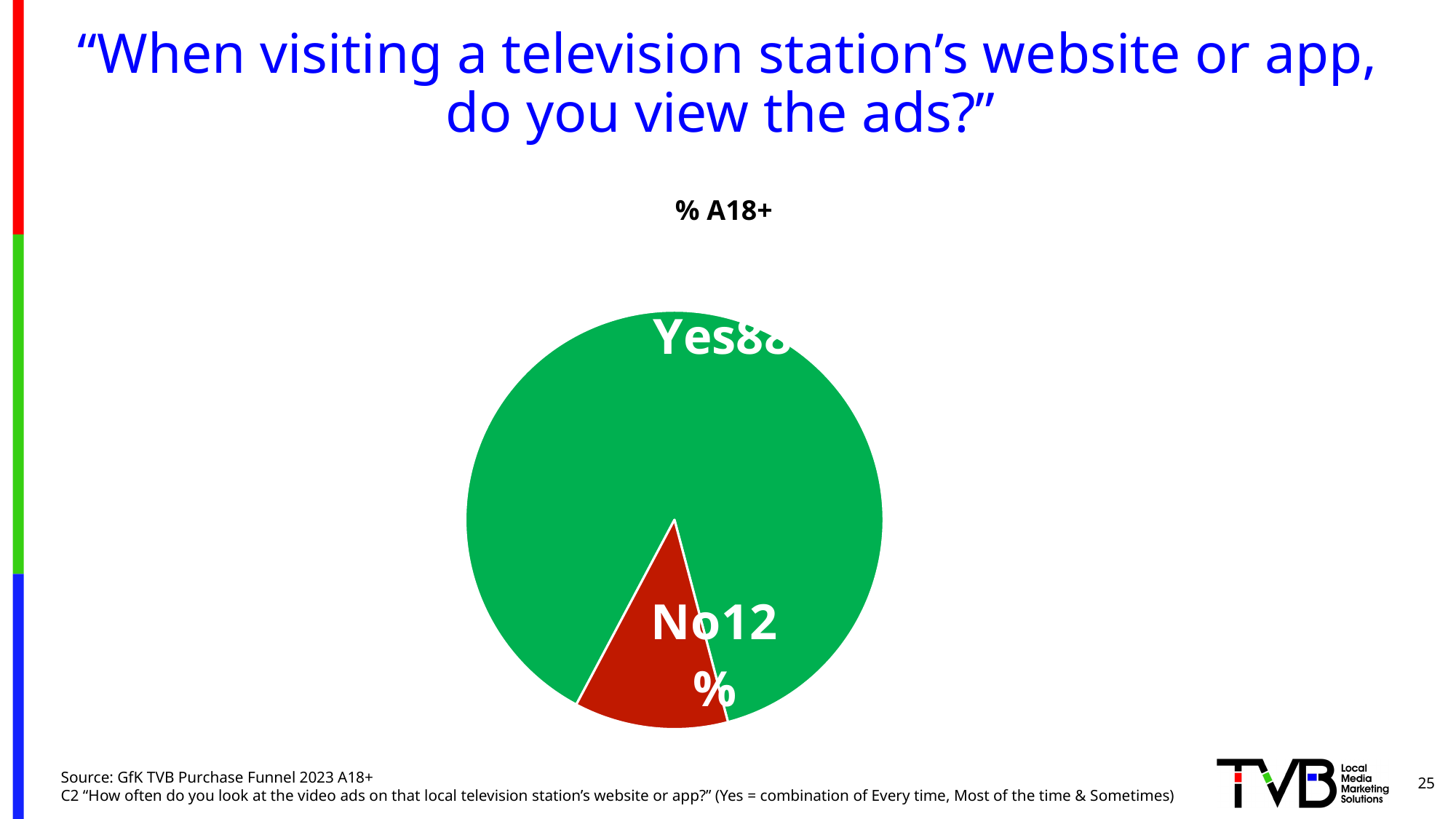
How many slices does the pie chart have? 2 What colour is the "No" slice of the pie chart? red Which response represents the largest slice of the pie chart? Yes What is the subtitle shown above the pie chart? % A18+ Which response represents the smallest slice of the pie chart? No Which response has the larger share of the pie, Yes or No? Yes What percentage of adults 18+ answered "No" to viewing ads on a television station's website or app? 12% What share of the pie does the "No" slice represent? 12% What kind of chart is shown on the slide? pie chart